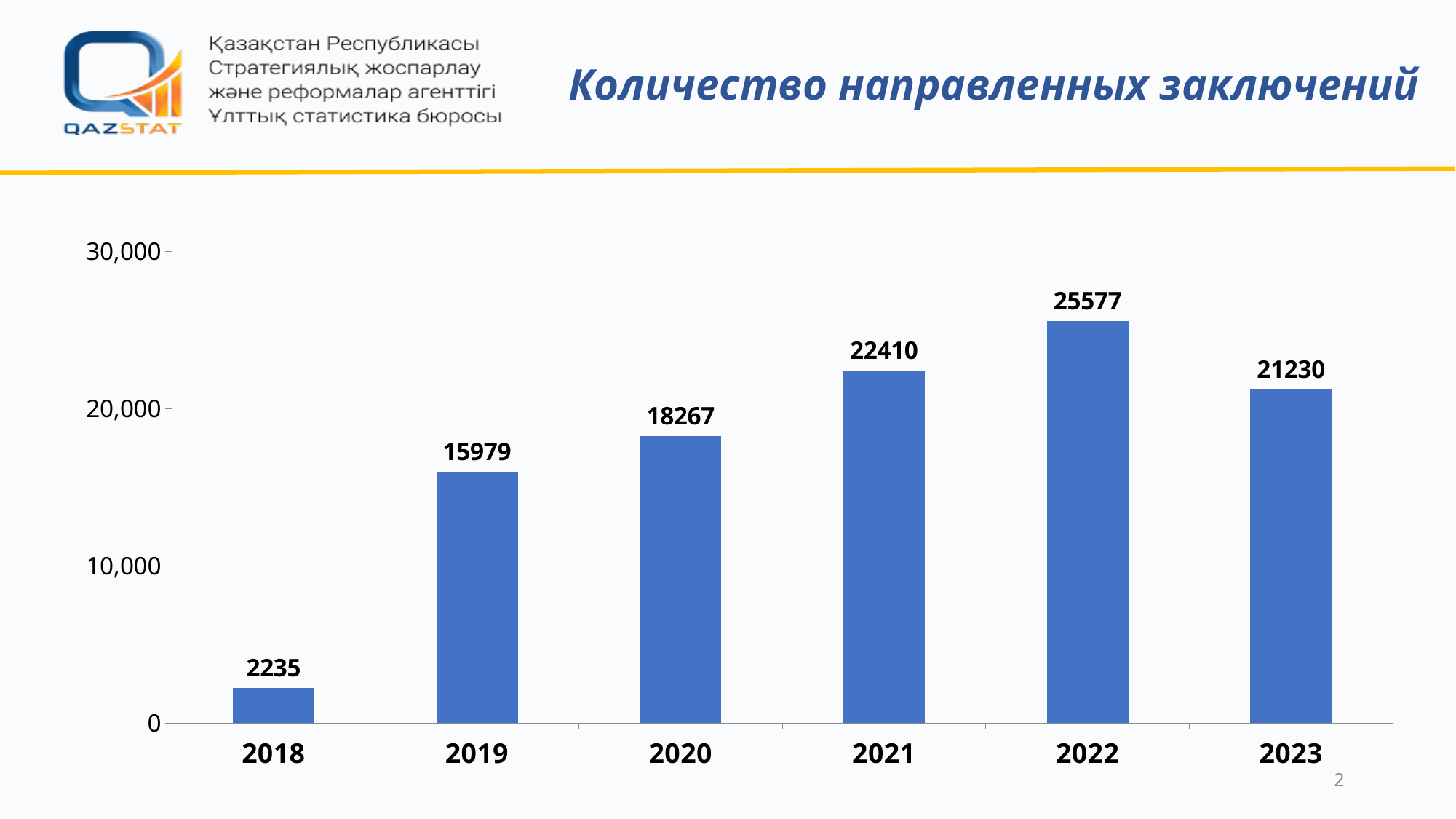
What is the title of the chart? Количество направленных заключений How many years are shown on the x axis? 6 What is the value for 2018? 2235 What is the value for 2023? 21230 What is the value for 2021? 22410 What is the difference between the values for 2022 and 2023? 4347 Which year has the highest value? 2022 What is the difference between the values for 2019 and 2018? 13744 Which is larger, the value for 2020 or the value for 2021? 2021 Which year has the lowest value? 2018 What kind of chart is shown on the slide? bar chart Is the value for 2020 greater or less than 20,000? less